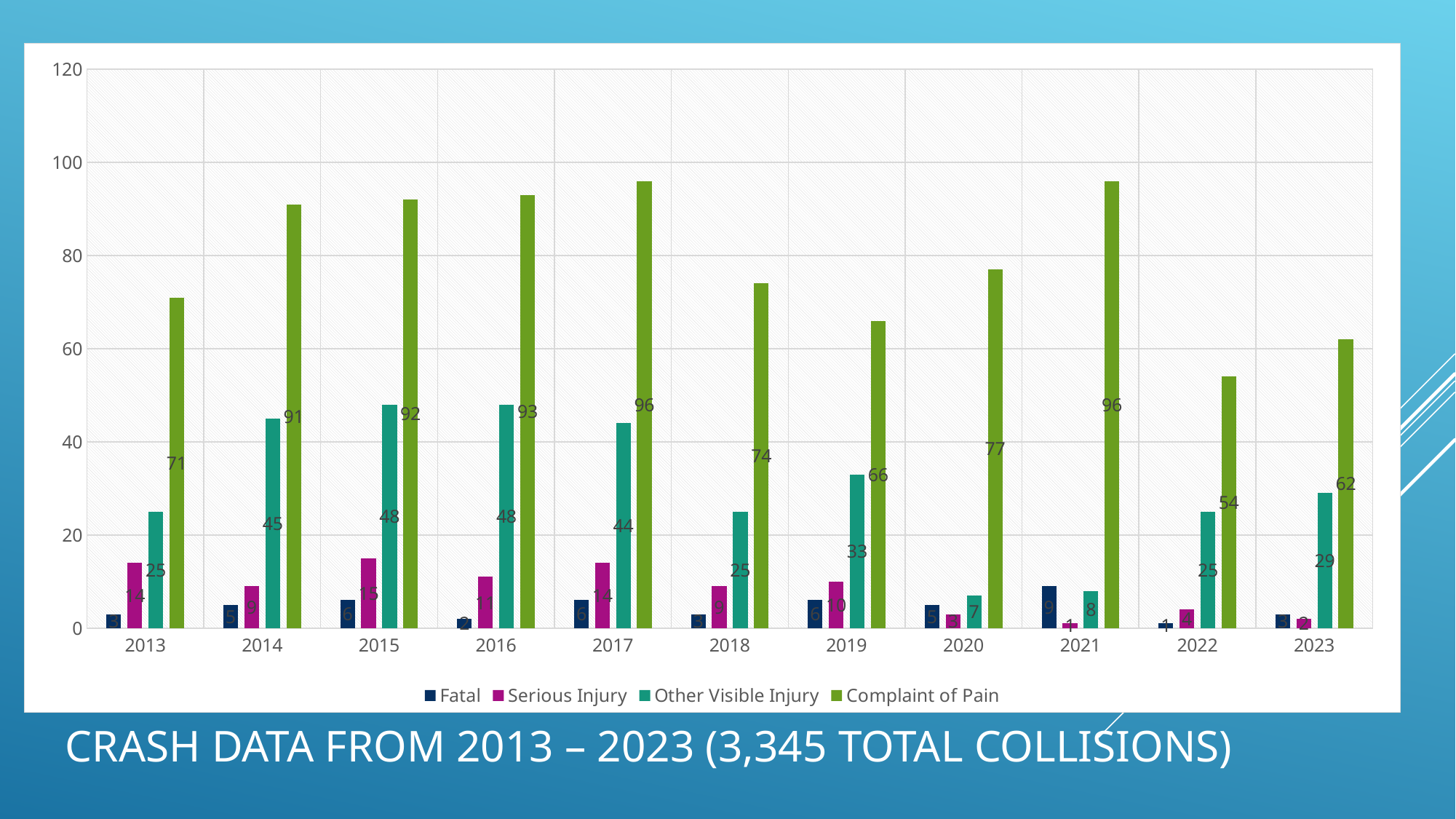
Which year has the larger Other Visible Injury value, 2019 or 2023? 2019 How many series does the legend list? 4 Is the Complaint of Pain value for 2014 greater or less than 80? greater What is the difference between the Complaint of Pain values for 2021 and 2022? 42 How many years are shown on the x axis? 11 In which year is the Complaint of Pain value lowest? 2022 In which year is the Other Visible Injury value lowest? 2020 What is the Other Visible Injury value for 2014? 45 What kind of chart is shown on the slide? bar chart What is the Complaint of Pain value for 2019? 66 What is the Fatal value for 2021? 9 What is the Serious Injury value for 2015? 15